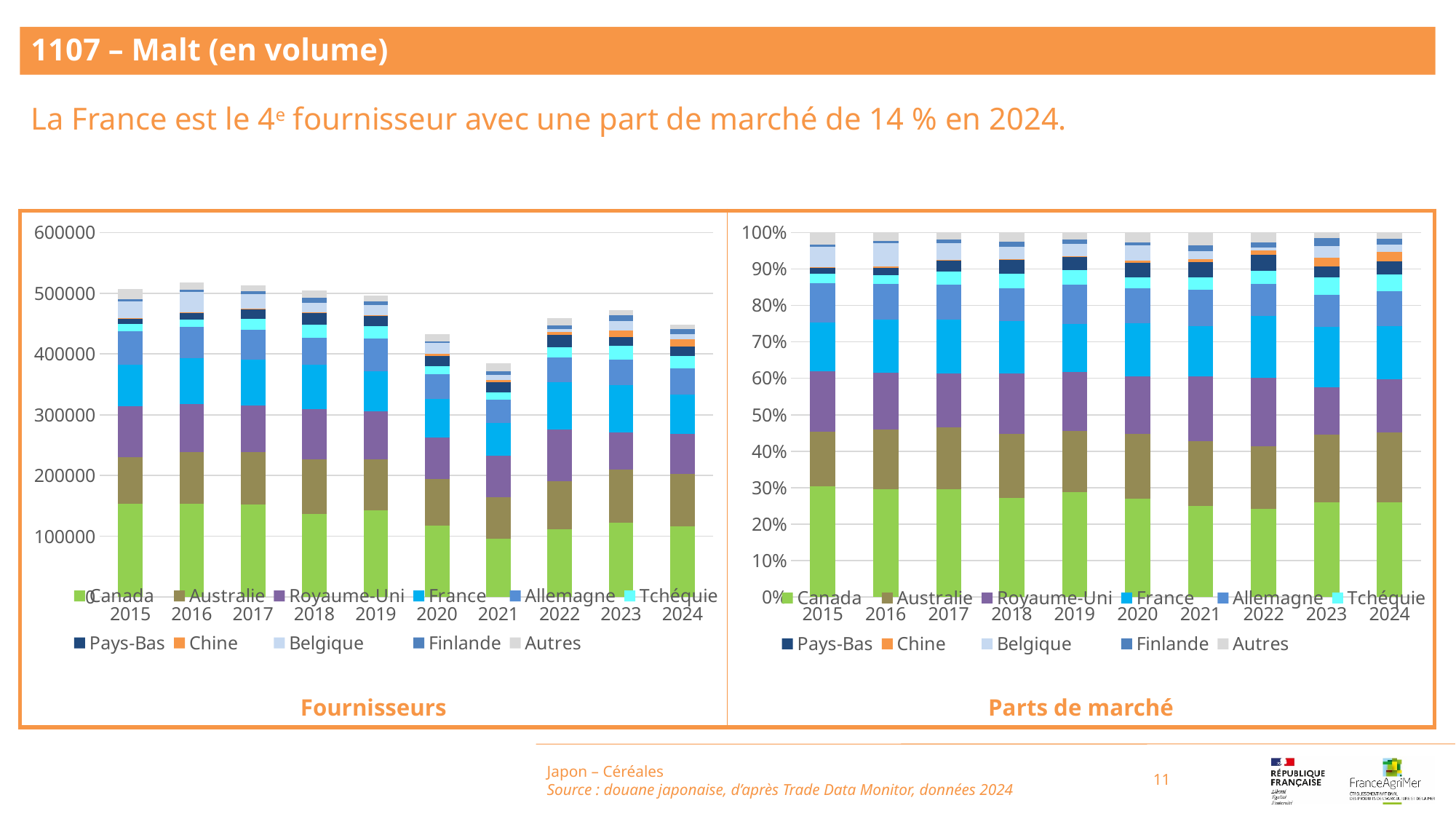
What type of chart is the 'Fournisseurs' chart on the left? Stacked bar chart What is the title of the chart on the right? Parts de marché In the 'Fournisseurs' chart, which total is larger, 2021 or 2022? 2022 In the 'Parts de marché' chart, is the Canada share in 2015 greater or less than 20%? greater In the 'Fournisseurs' chart, is the total for 2021 greater or less than 400000? less How many series does the legend of the 'Parts de marché' chart list? 11 In the 'Fournisseurs' chart, which year has the lowest total stacked bar? 2021 In the 'Fournisseurs' chart, do the total bars rise or fall from 2019 to 2021? fall In the 'Fournisseurs' chart, is the total for 2016 greater or less than 500000? greater How many years are shown on the x axis of the 'Fournisseurs' chart? 10 Which series is shown at the bottom of each stacked bar in both charts? Canada